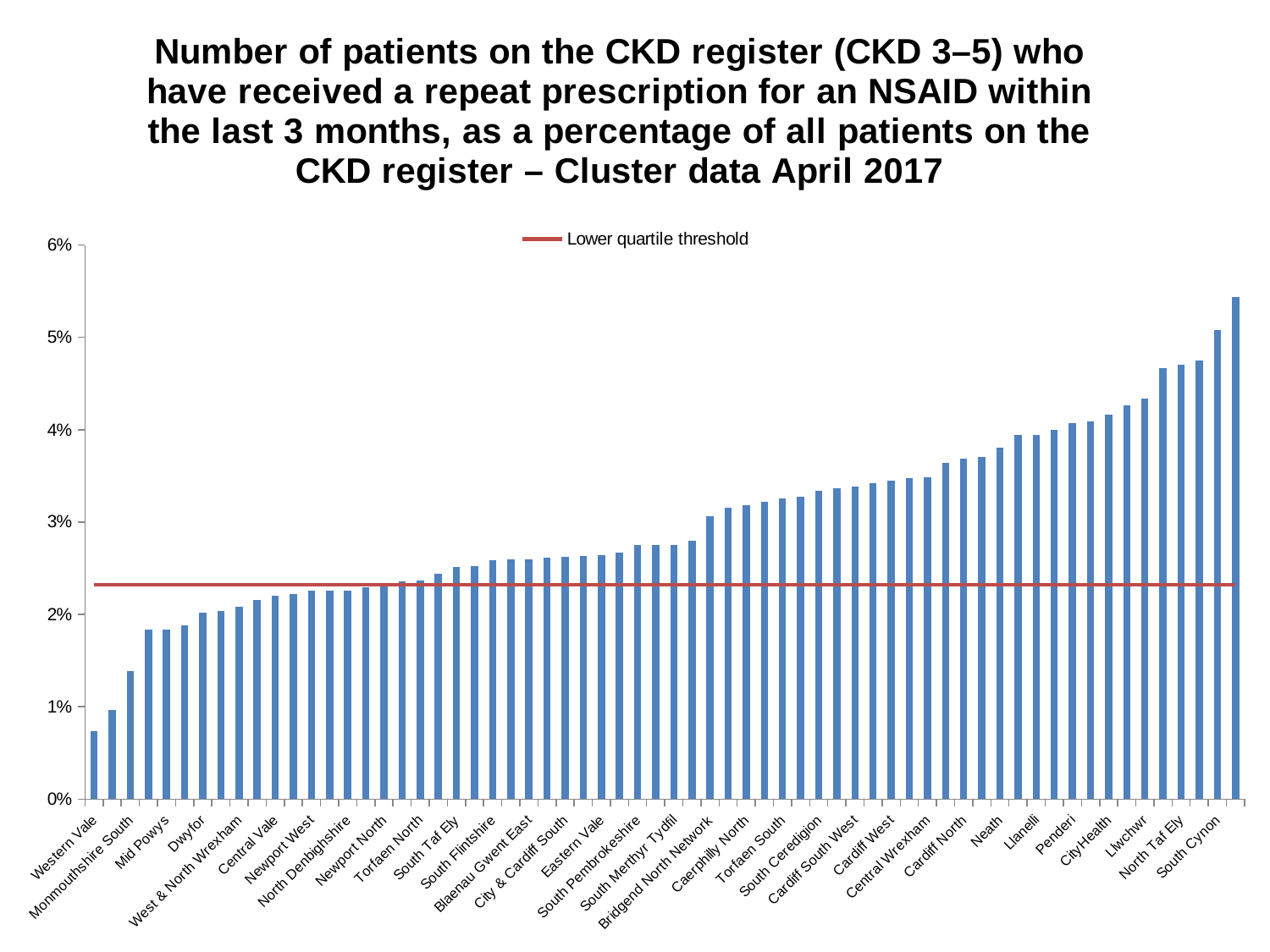
Is the value for Neath greater or less than 3%? greater Is the value for South Cynon greater or less than 4%? greater Is the value for North Taf Ely greater or less than 4%? greater What does the red horizontal line on the chart represent, according to the legend? Lower quartile threshold Do the bar values rise or fall from left to right along the x axis? rise What kind of chart is shown on the slide? bar chart Which has the larger value, Western Vale or South Cynon? South Cynon Which cluster has the lowest value on the chart? Western Vale